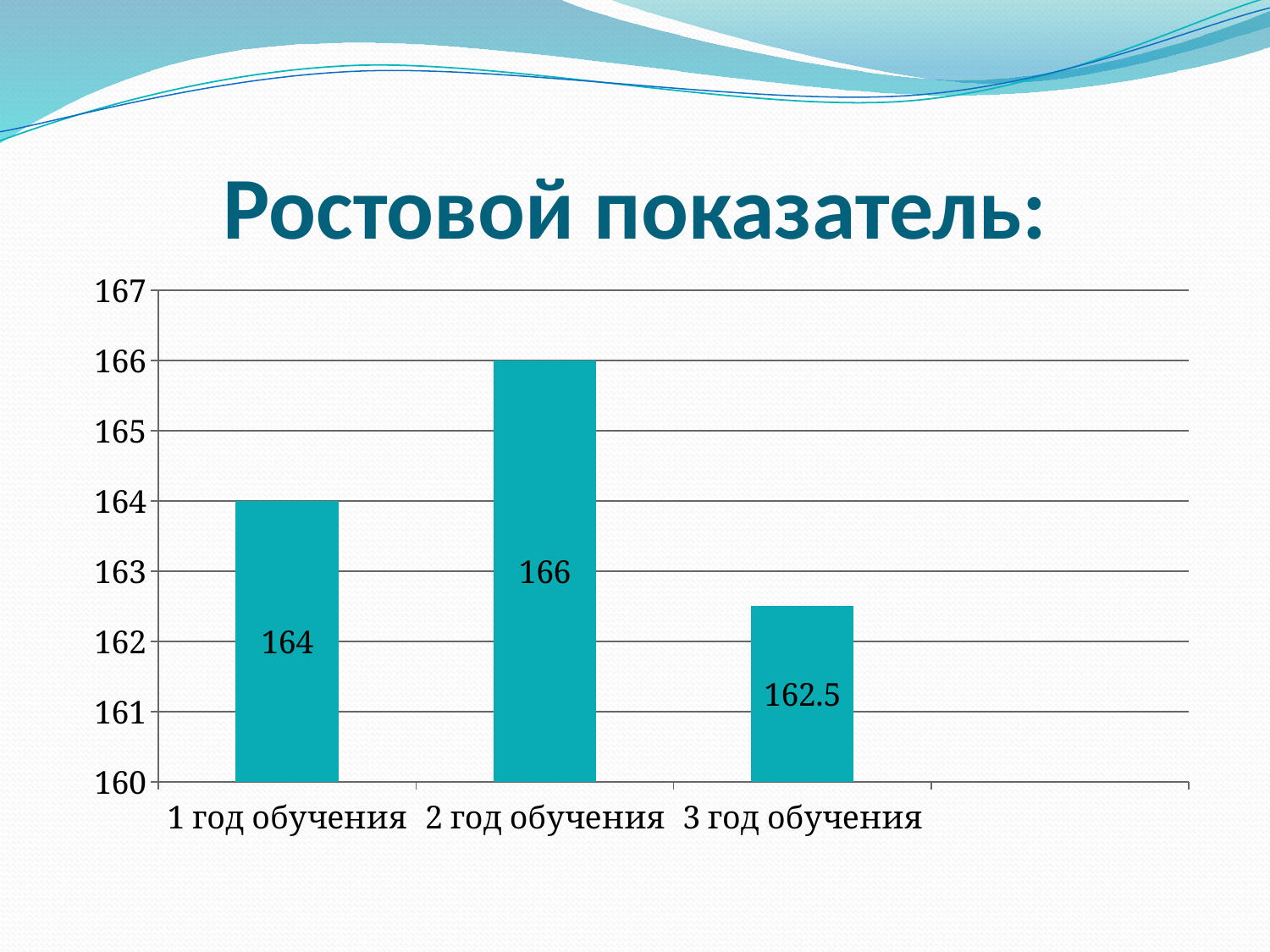
What is the difference between the values for 1 год обучения and 3 год обучения? 1.5 Is the value for 3 год обучения greater or less than 163? less What is the value for 1 год обучения? 164 Which category has the lowest value? 3 год обучения Which category has the highest value? 2 год обучения How many categories are shown on the x axis? 3 What is the title of the slide? Ростовой показатель: What is the value for 3 год обучения? 162.5 Which is larger, the value for 1 год обучения or 3 год обучения? 1 год обучения What kind of chart is shown on the slide? bar chart What is the value for 2 год обучения? 166 What is the difference between the values for 2 год обучения and 1 год обучения? 2